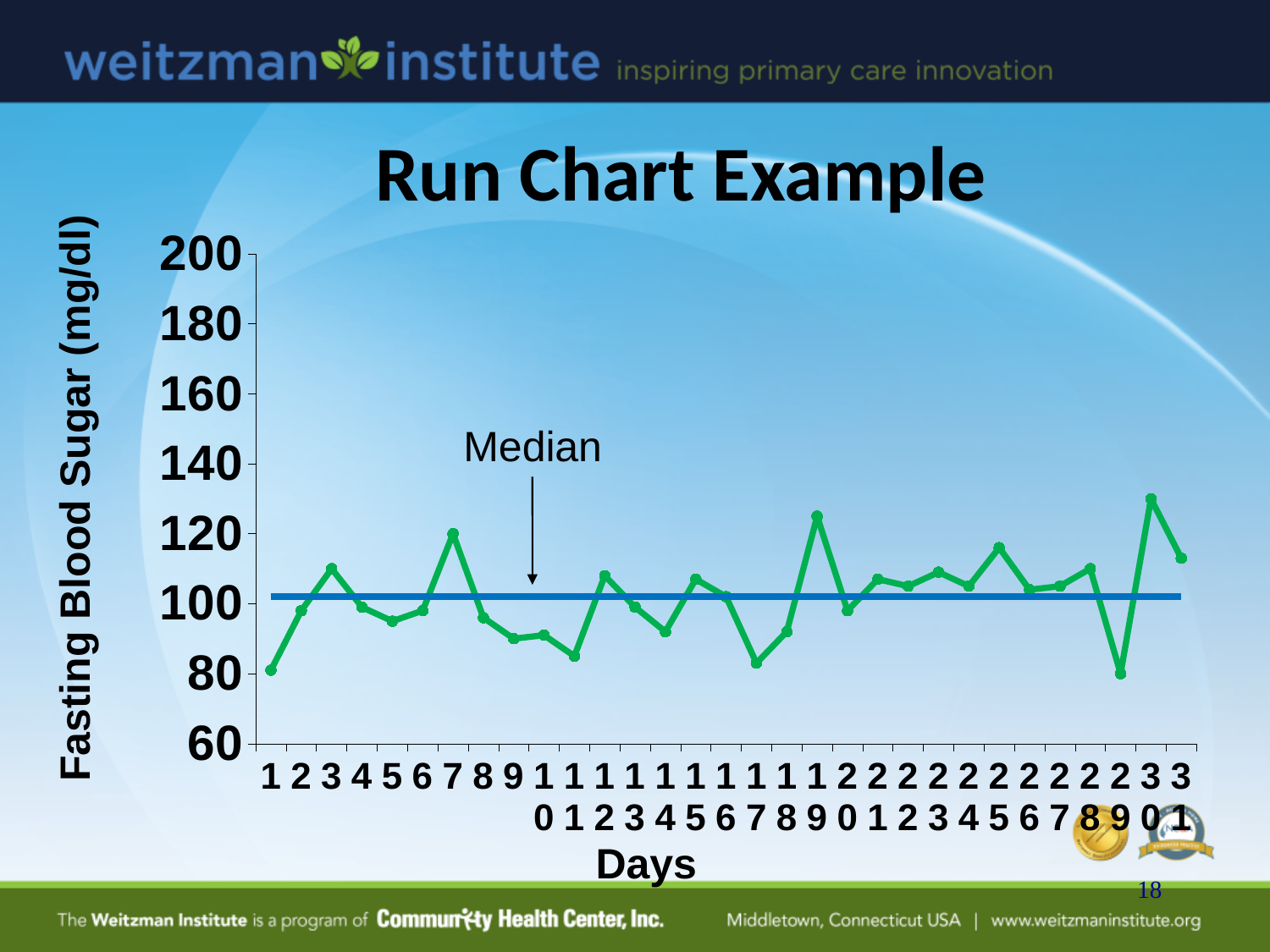
Is the value for day 7 greater or less than 100? greater Is the value for day 17 greater or less than 100? less Which has the higher fasting blood sugar, day 7 or day 11? day 7 On which day is the fasting blood sugar highest? 30 Is the value for day 29 greater or less than 100? less Which has the higher fasting blood sugar, day 30 or day 29? day 30 What is the title of the chart? Run Chart Example How many days are plotted on the x axis? 31 What is the label of the vertical axis? Fasting Blood Sugar (mg/dl) What kind of chart is shown on the slide? line chart